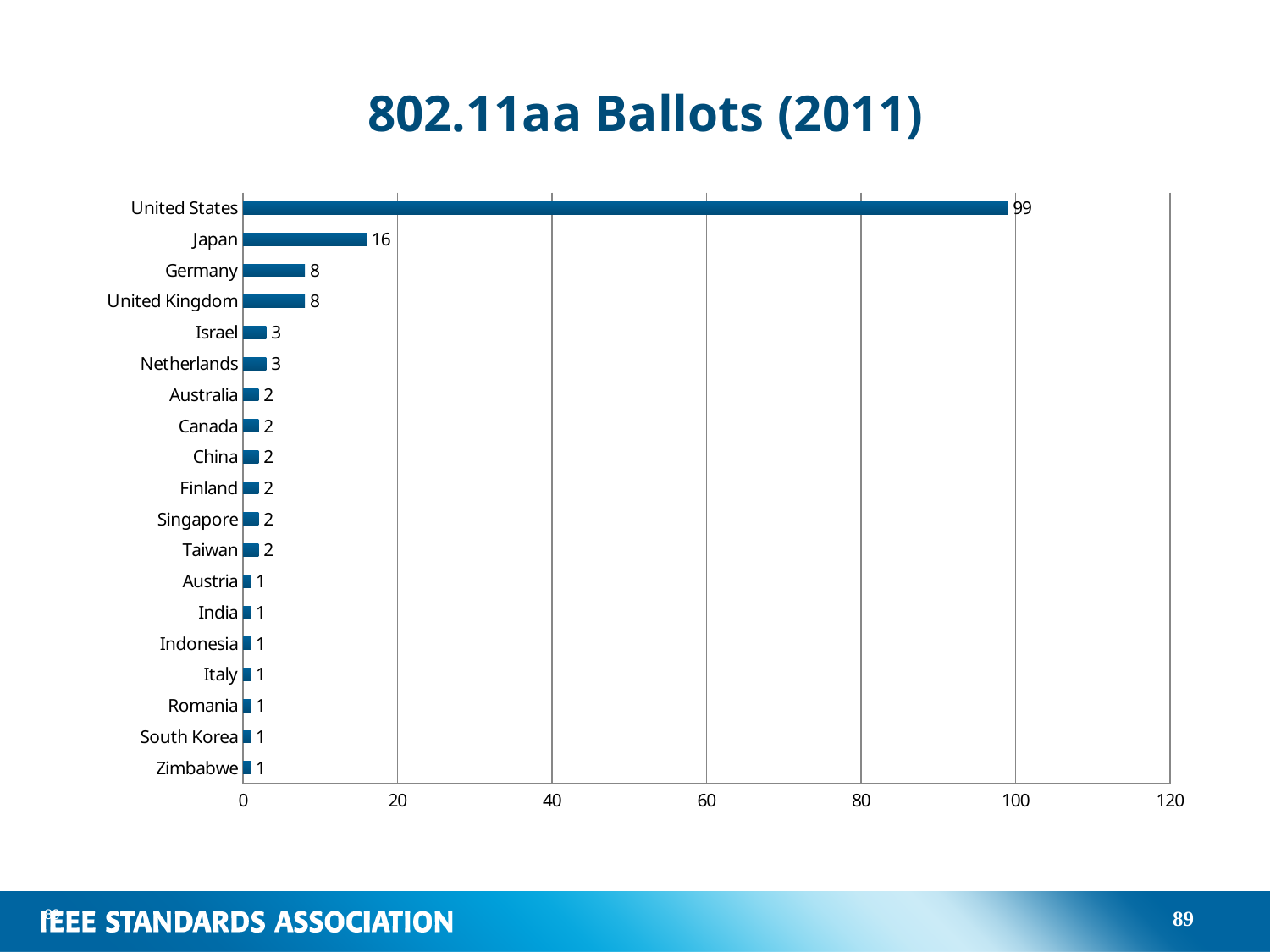
Which is larger, the value for Japan or the value for Germany? Japan What kind of chart is shown on the slide? bar chart Which country has the highest number of ballots? United States Is the value for the United States greater or less than 80? greater What is the value for Germany? 8 What is the value for Japan? 16 What is the difference between the values for the United States and Japan? 83 What is the value for Israel? 3 How many countries are shown in the chart? 19 What is the difference between the values for Japan and the United Kingdom? 8 What is the value for the United States? 99 What is the title of the chart? 802.11aa Ballots (2011)